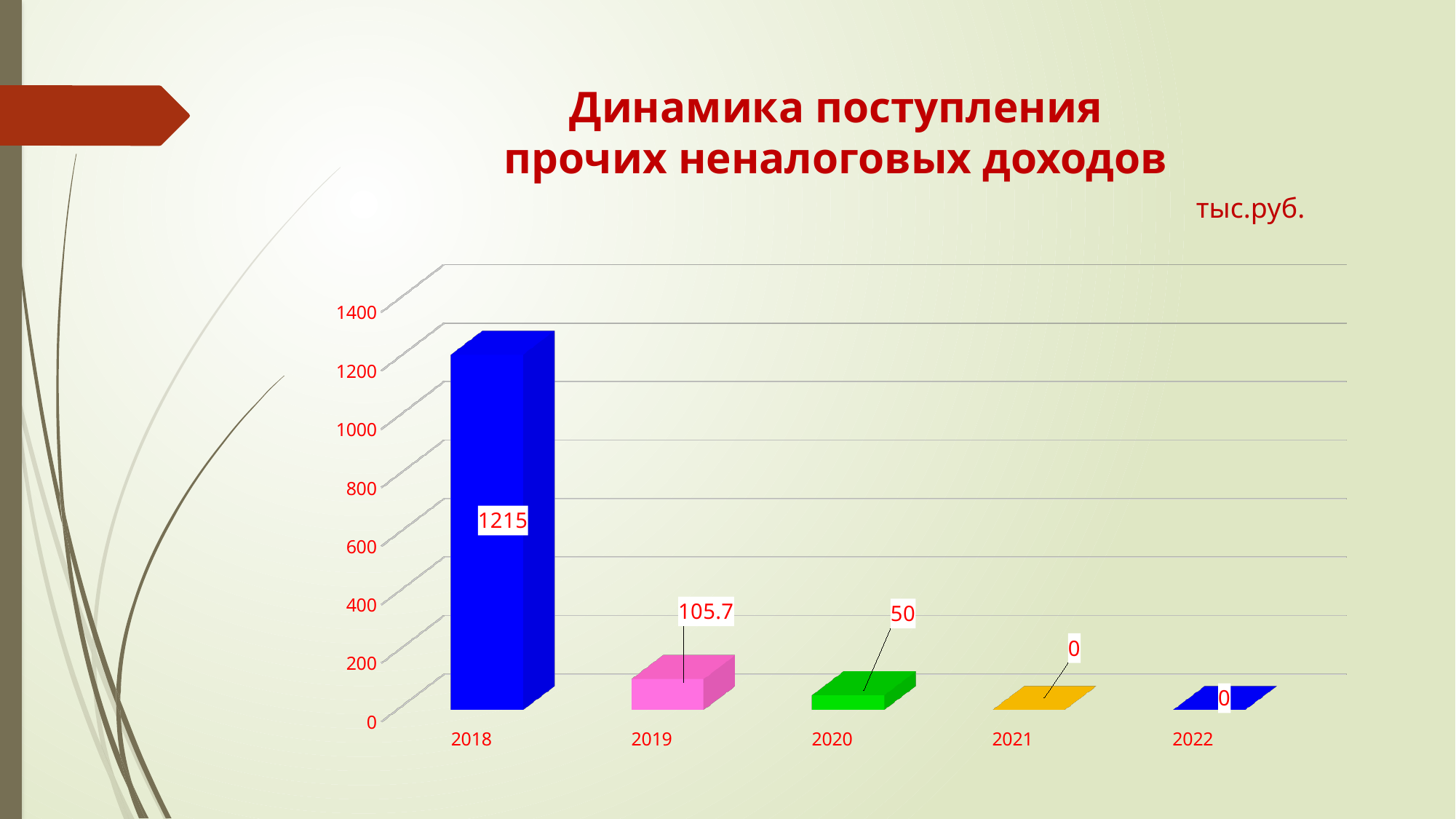
What is the value for 2021? 0 What is the difference between the values for 2019 and 2020? 55.7 What is the value for 2020? 50 What is the difference between the values for 2018 and 2019? 1109.3 What kind of chart is shown on the slide? bar chart What is the value for 2018? 1215 Which year has the highest value? 2018 How many years are shown on the x axis? 5 Do the values rise or fall from 2018 to 2021? fall What is the value for 2019? 105.7 Is the value for 2018 greater or less than 1000? greater Which is larger, the value for 2019 or the value for 2020? 2019